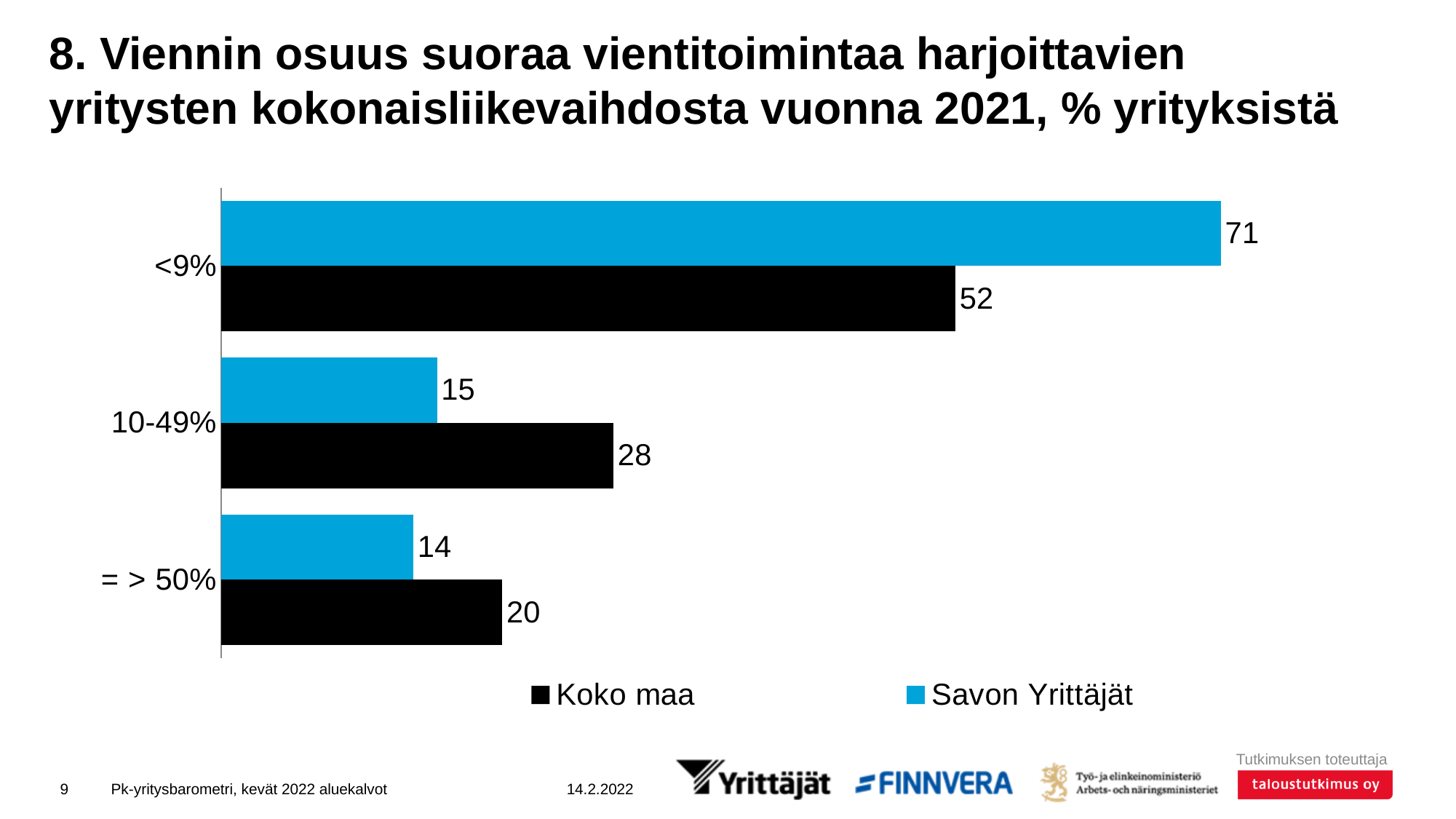
Which category has the lowest value for Savon Yrittäjät? = > 50% What is the value for Savon Yrittäjät in the <9% category? 71 How many series does the legend list? 2 In the = > 50% category, which series has the larger value, Koko maa or Savon Yrittäjät? Koko maa What is the value for Koko maa in the = > 50% category? 20 What is the difference between Savon Yrittäjät and Koko maa in the <9% category? 19 What is the difference between Koko maa and Savon Yrittäjät in the 10-49% category? 13 What is the value for Koko maa in the <9% category? 52 How many categories are shown on the chart? 3 Which category has the highest value for Koko maa? <9% What kind of chart is shown on the slide? Bar chart What is the value for Savon Yrittäjät in the 10-49% category? 15